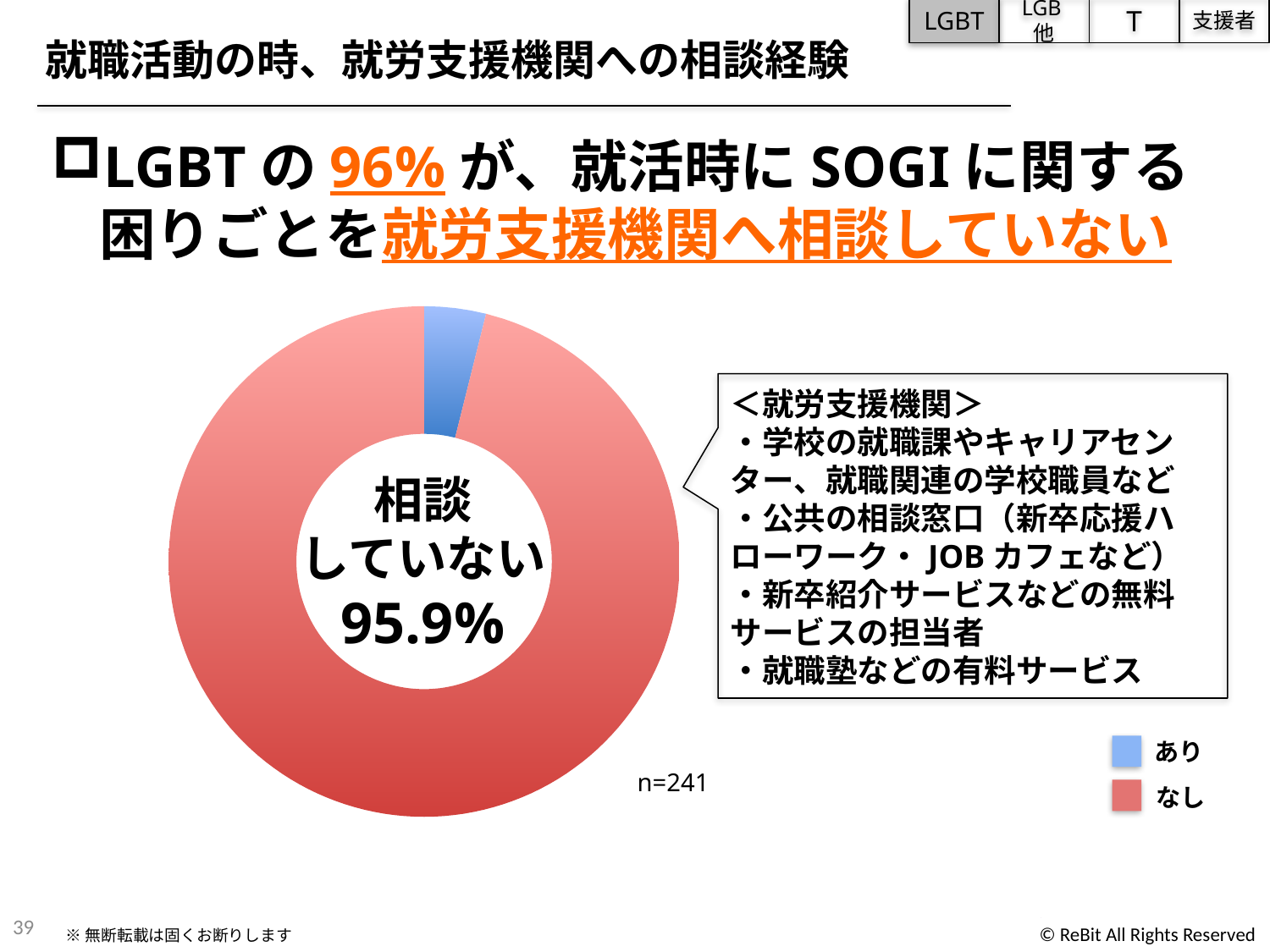
What percentage is shown for the なし (相談していない) slice of the pie chart? 95.9% What kind of chart is shown on the slide? doughnut chart What colour is the あり slice in the pie chart? blue How many categories does the pie chart show? 2 Which category has the largest slice in the pie chart? なし Which category has the smallest slice in the pie chart? あり What share of the pie does the なし slice represent? 95.9% What sample size (n) is shown next to the pie chart? n=241 Which slice is larger in the pie chart, あり or なし? なし How many entries does the legend of the pie chart list? 2